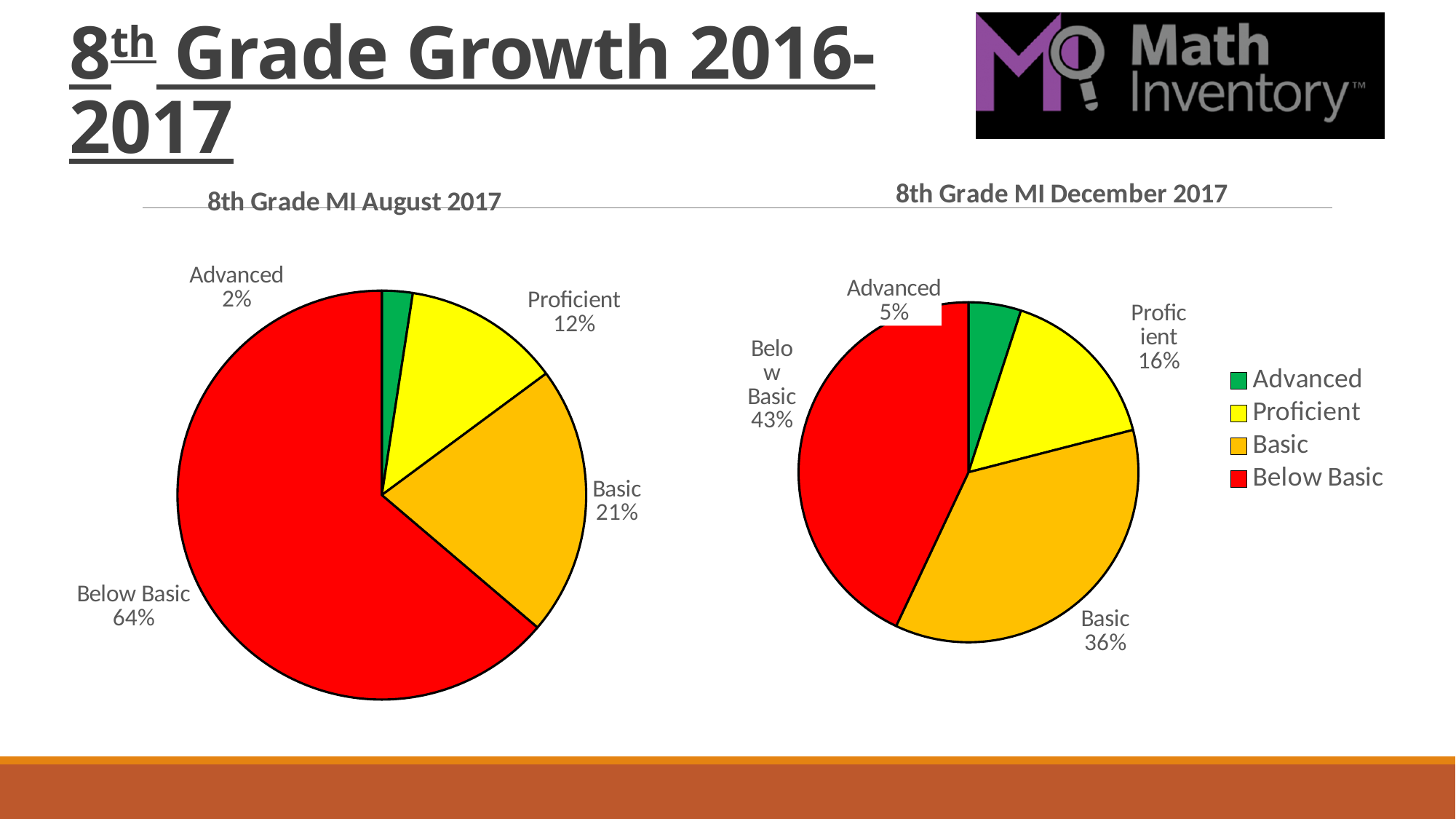
In the '8th Grade MI December 2017' chart, what colour represents Proficient? Yellow In the '8th Grade MI August 2017' chart, what percentage is labelled for Proficient? 12% In the '8th Grade MI December 2017' chart, which category has the smallest slice? Advanced In the '8th Grade MI December 2017' chart, what percentage is labelled for Advanced? 5% Which is larger: the Basic share in the August 2017 chart or the Basic share in the December 2017 chart? December 2017 In the '8th Grade MI August 2017' chart, which category has the largest slice? Below Basic How many entries does the legend next to the '8th Grade MI December 2017' chart list? 4 What is the difference between the Below Basic share in the August 2017 chart and the Below Basic share in the December 2017 chart? 21% How many categories does the '8th Grade MI August 2017' pie chart have? 4 In the '8th Grade MI August 2017' chart, what share of the pie is Below Basic? 64% In the '8th Grade MI December 2017' chart, what share of the pie is Basic? 36% What type of chart is '8th Grade MI December 2017'? Pie chart